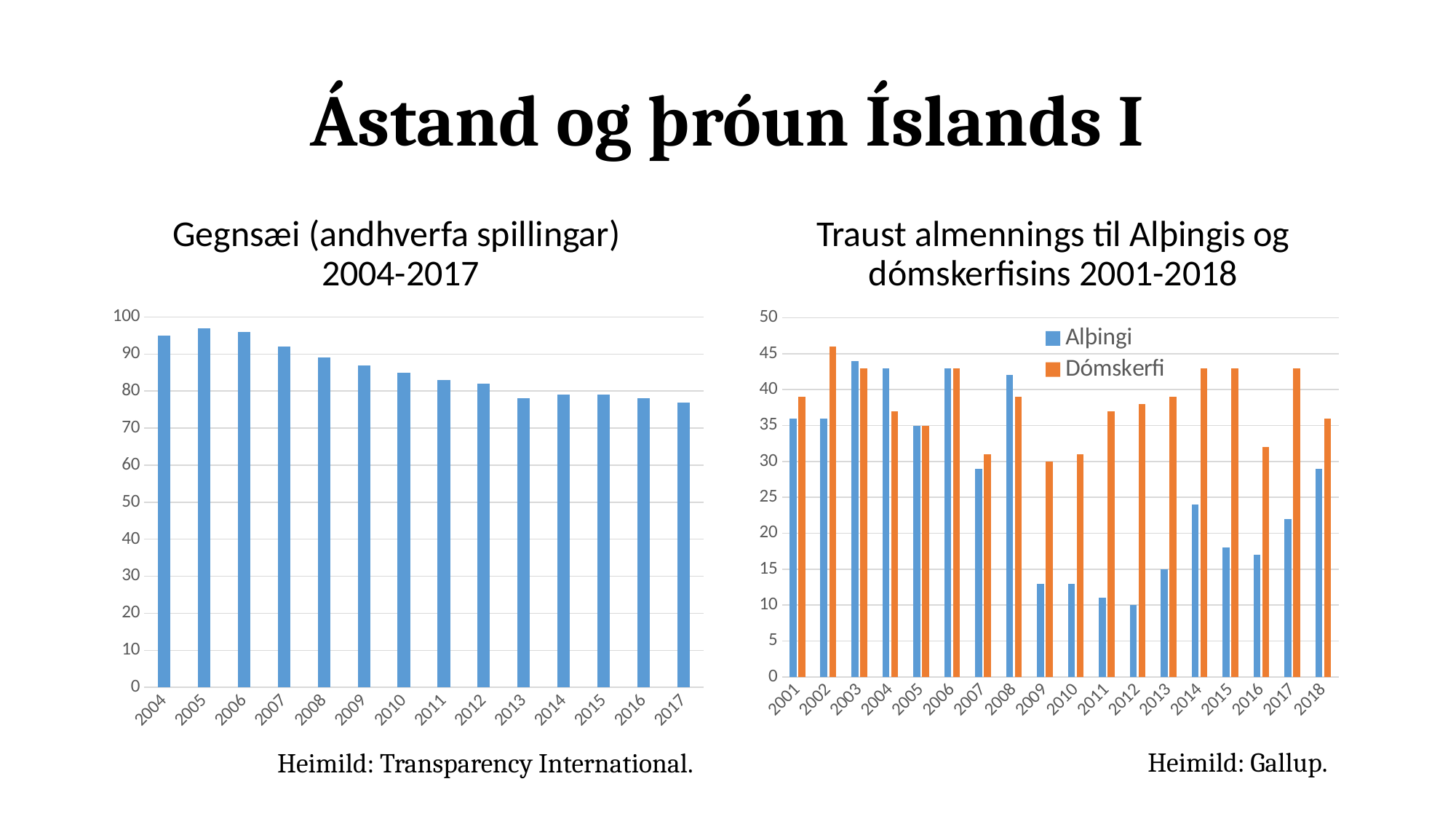
In the left chart, 'Gegnsæi (andhverfa spillingar) 2004-2017', do the values generally rise or fall from 2004 to 2017? fall In the left chart, 'Gegnsæi (andhverfa spillingar) 2004-2017', is the value for 2004 greater or less than 90? greater In the left chart, 'Gegnsæi (andhverfa spillingar) 2004-2017', is the value for 2017 greater or less than 80? less How many years are shown on the x axis of the right chart, 'Traust almennings til Alþingis og dómskerfisins 2001-2018'? 18 In the right chart, 'Traust almennings til Alþingis og dómskerfisins 2001-2018', which series has the larger value in 2009, Alþingi or Dómskerfi? Dómskerfi How many series does the legend of the right chart, 'Traust almennings til Alþingis og dómskerfisins 2001-2018', list? 2 How many years are shown on the x axis of the left chart, 'Gegnsæi (andhverfa spillingar) 2004-2017'? 14 In the right chart, 'Traust almennings til Alþingis og dómskerfisins 2001-2018', is the Alþingi value for 2012 greater or less than 15? less In the right chart, 'Traust almennings til Alþingis og dómskerfisins 2001-2018', which series is shown in orange? Dómskerfi In the left chart, 'Gegnsæi (andhverfa spillingar) 2004-2017', which is larger, the value for 2006 or the value for 2012? 2006 In the right chart, 'Traust almennings til Alþingis og dómskerfisins 2001-2018', in which year is the Dómskerfi value highest? 2002 What kind of chart is the left chart, 'Gegnsæi (andhverfa spillingar) 2004-2017'? bar chart